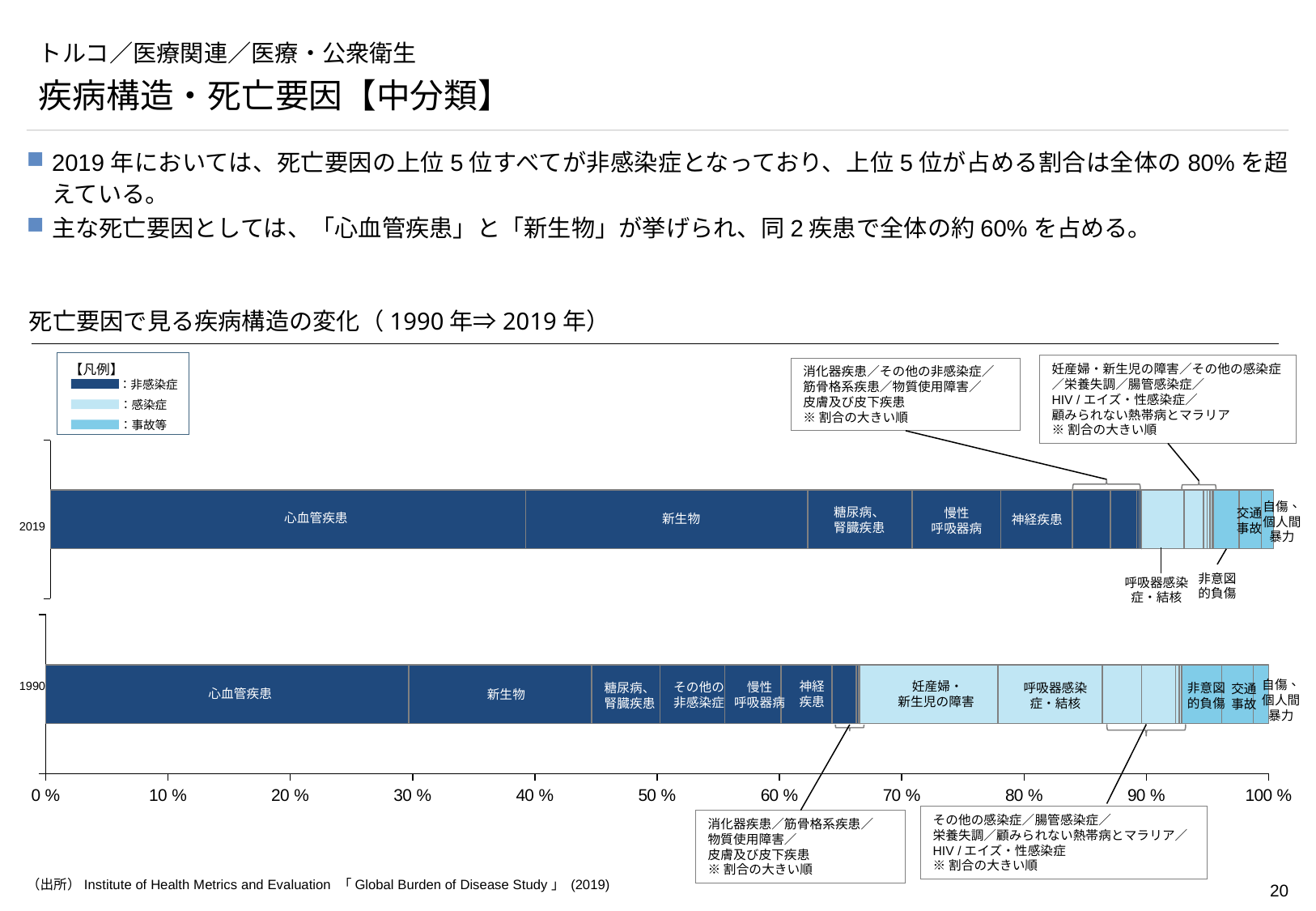
What is the title of the chart? 死亡要因で見る疾病構造の変化（1990年⇒2019年） Which year has the larger share for 新生物, 1990 or 2019? 2019 How many years (bars) does the chart compare? 2 Which cause of death has the largest share in the 1990 bar? 心血管疾患 How many categories does the legend (凡例) list? 3 Is the share of 心血管疾患 in 2019 greater or less than 30%? greater What kind of chart is shown on the slide? Stacked bar chart Which cause of death has the largest share in the 2019 bar? 心血管疾患 Is the share of 心血管疾患 in 1990 greater or less than 20%? greater Is the share of 妊産婦・新生児の障害 in 1990 greater or less than 20%? less Which year has the larger share for 呼吸器感染症・結核, 1990 or 2019? 1990 Which legend category is shown in dark blue? 非感染症